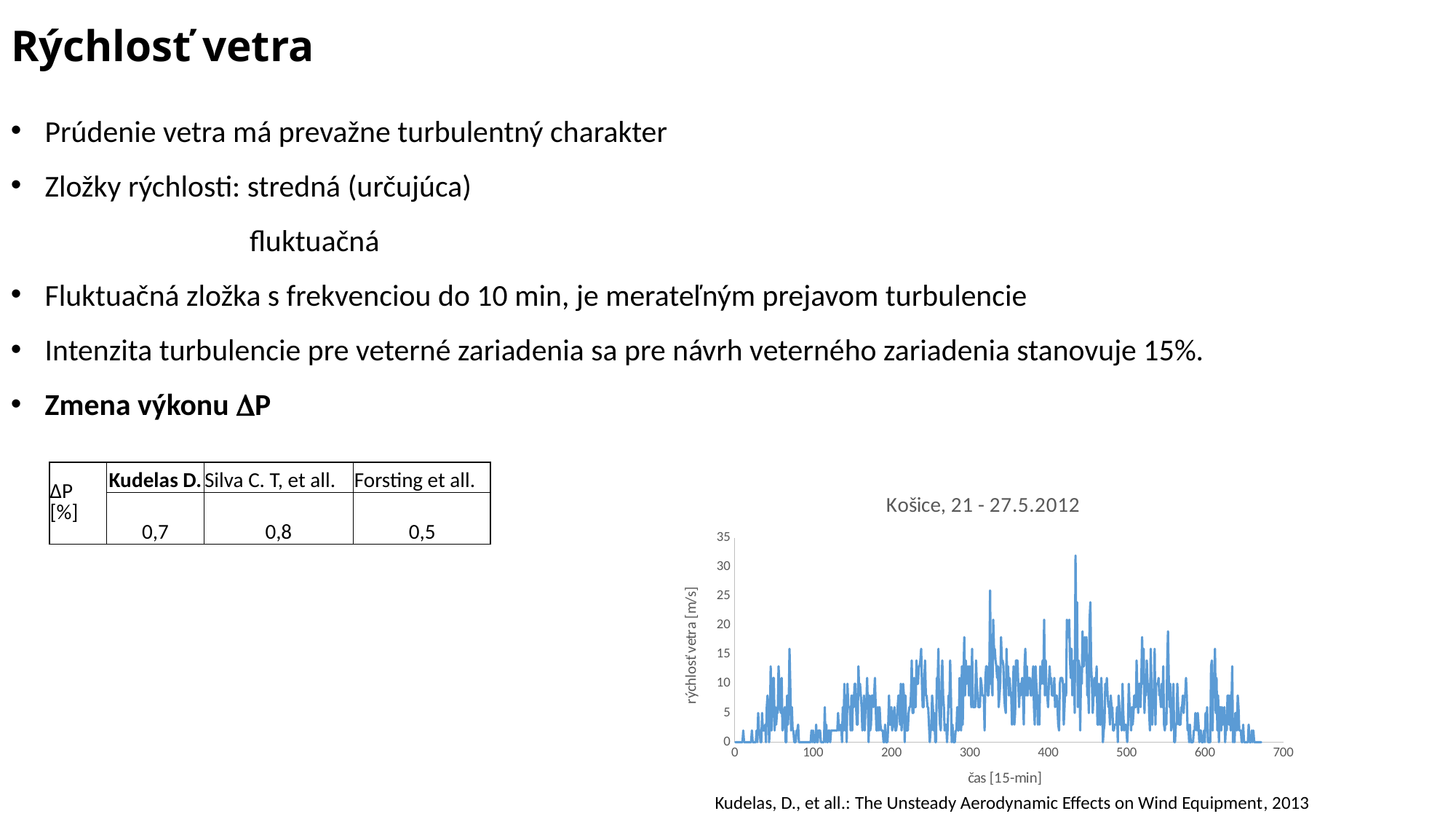
Is the wind speed value at time 600 on the chart greater or less than 20? less Is the highest wind speed value plotted on the chart greater or less than 25? greater What is the title of the chart? Košice, 21 - 27.5.2012 What kind of chart is shown on the slide? line chart Is the wind speed value at time 100 on the chart greater or less than 5? less What is the label of the vertical axis of the chart? rýchlosť vetra [m/s] How many data series (lines) are plotted on the chart? 1 What is the highest tick value shown on the vertical axis of the chart? 35 What is the highest tick value shown on the horizontal axis of the chart? 700